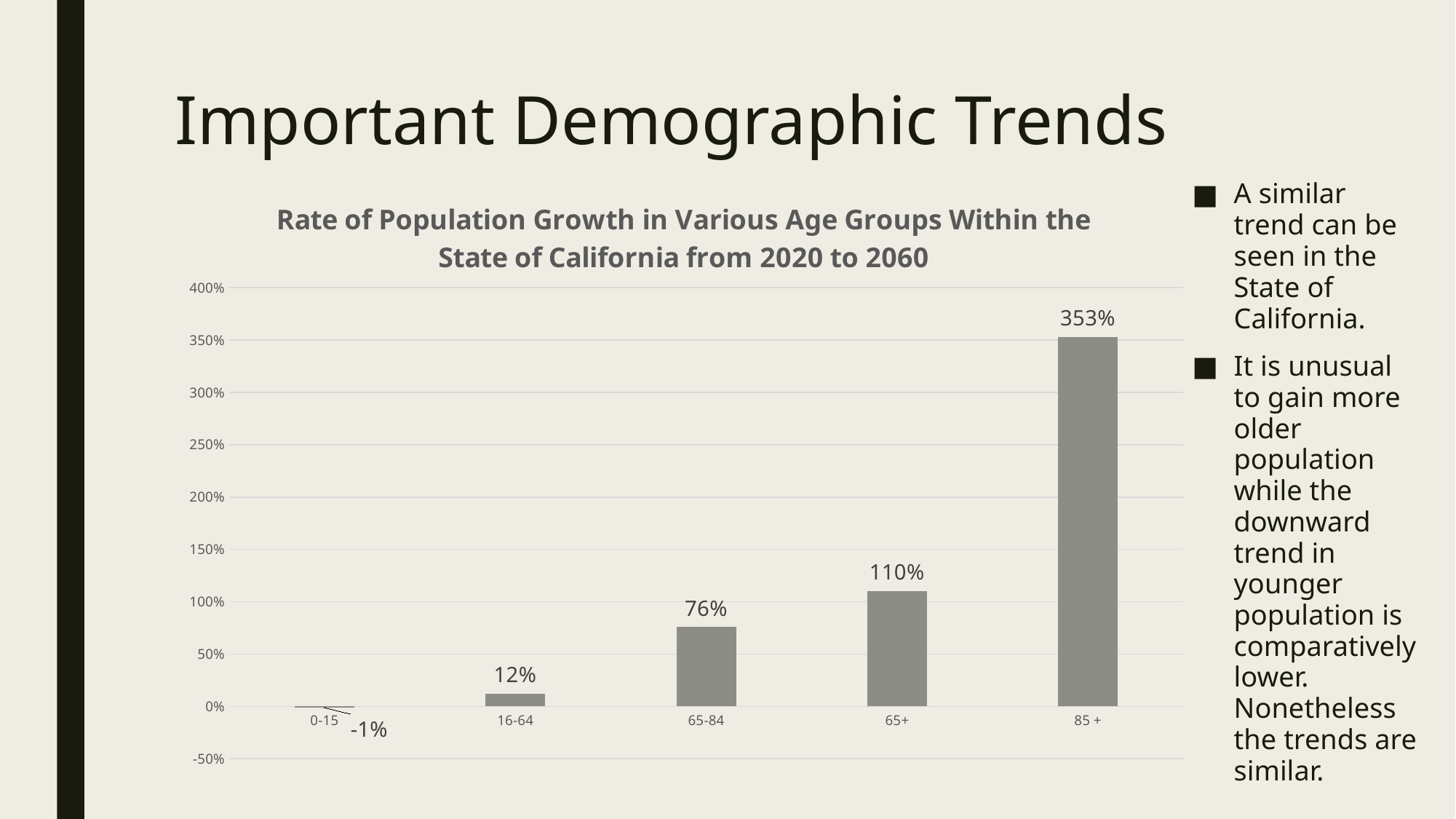
What is the rate of population growth for the 0-15 age group? -1% What type of chart is shown on the slide? Bar chart What is the rate of population growth for the 85 + age group? 353% What is the rate of population growth for the 65-84 age group? 76% What is the title of the chart? Rate of Population Growth in Various Age Groups Within the State of California from 2020 to 2060 Which age group has the highest rate of population growth? 85 + What is the difference between the growth rates of the 65+ and 65-84 age groups? 34% Do the growth rates rise or fall moving from the 0-15 group to the 85 + group along the x axis? Rise How many age groups are shown in the chart? 5 Which has a higher growth rate, the 16-64 age group or the 65-84 age group? 65-84 Which age group has the lowest rate of population growth? 0-15 What is the rate of population growth for the 16-64 age group? 12%